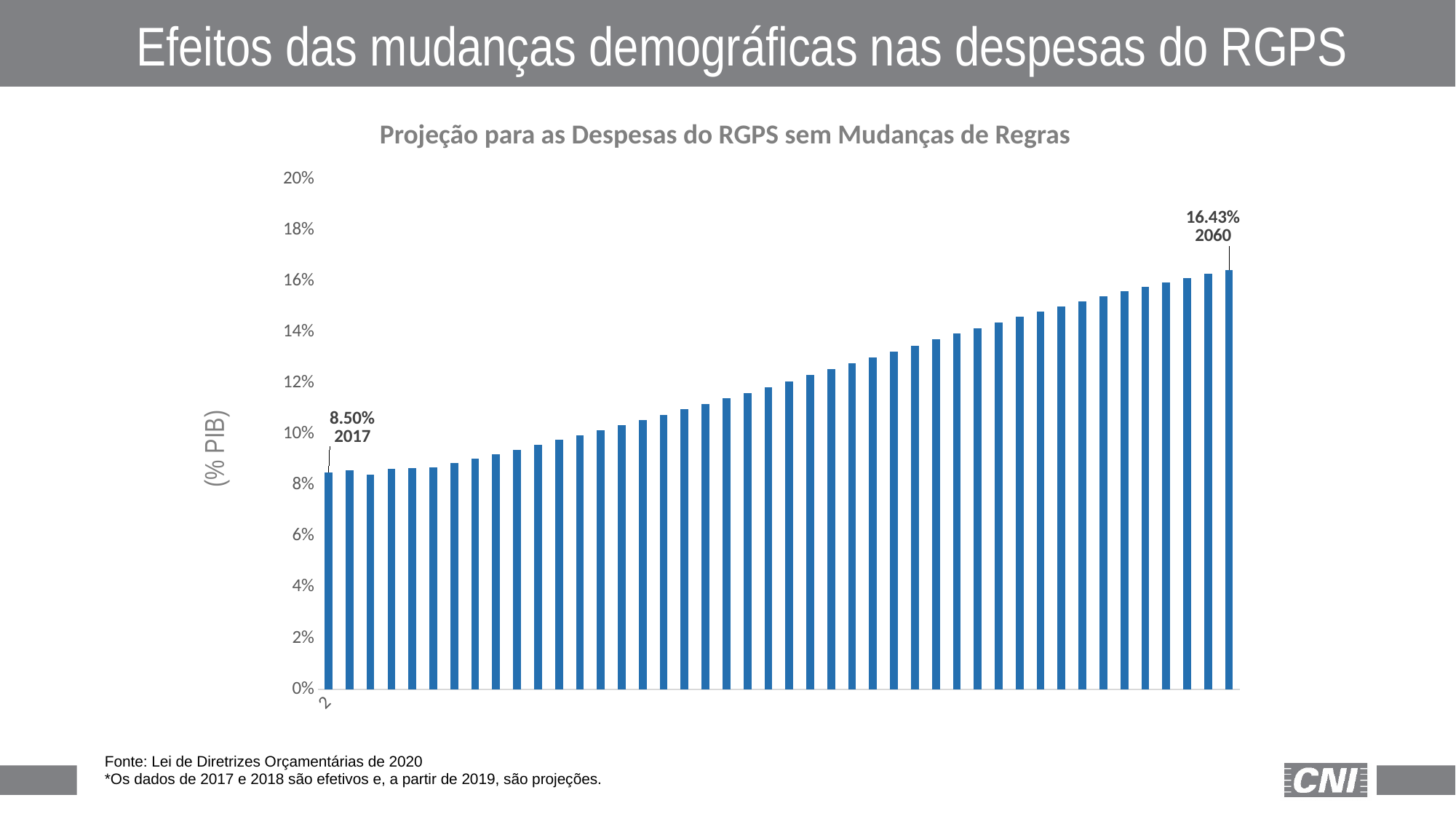
What is the value for 2017 in the chart? 8.50% Which is larger, the value for 2017 or the value for 2060? 2060 What kind of chart is shown on the slide? bar chart What is the title of the chart? Projeção para as Despesas do RGPS sem Mudanças de Regras Do the values rise or fall from left to right along the x axis? rise Is the value for 2017 greater or less than 10%? less Is the value for 2060 greater or less than 14%? greater What is the highest value shown on the vertical axis? 20% What is the difference between the 2060 value and the 2017 value? 7.93 percentage points Which year has the highest value in the chart? 2060 What is the label on the vertical axis of the chart? (% PIB) What is the projected value for 2060 in the chart? 16.43%